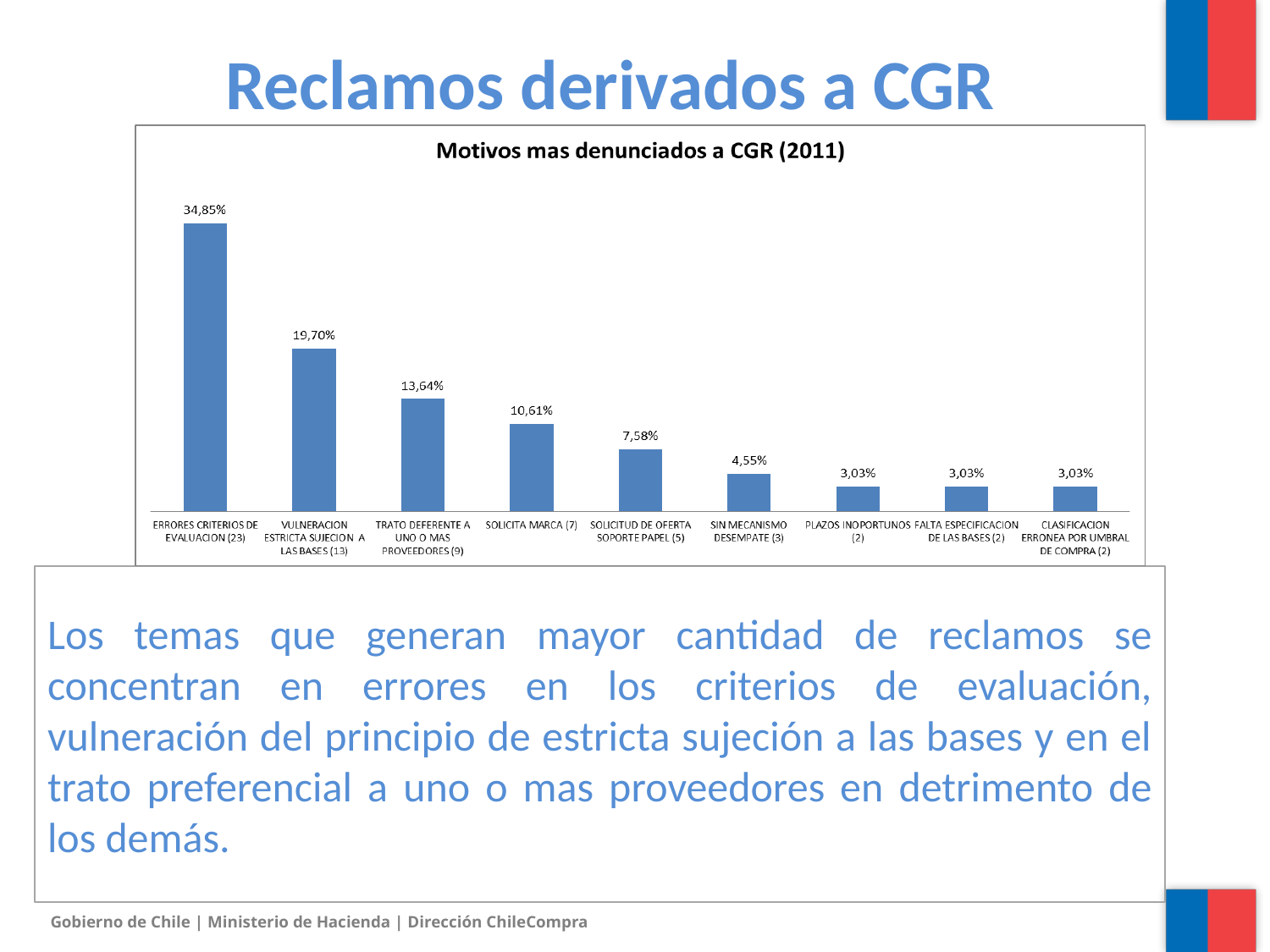
What is the difference between the values for ERRORES CRITERIOS DE EVALUACION (23) and VULNERACION ESTRICTA SUJECION A LAS BASES (13)? 15,15% What is the value for ERRORES CRITERIOS DE EVALUACION (23)? 34,85% What type of chart is shown on the slide? bar chart Which is larger, the value for TRATO DEFERENTE A UNO O MAS PROVEEDORES (9) or SOLICITUD DE OFERTA SOPORTE PAPEL (5)? TRATO DEFERENTE A UNO O MAS PROVEEDORES (9) How many categories are shown in the chart? 9 What is the value for VULNERACION ESTRICTA SUJECION A LAS BASES (13)? 19,70% What is the value for SIN MECANISMO DESEMPATE (3)? 4,55% What is the title of the chart? Motivos mas denunciados a CGR (2011) Which category has the highest value? ERRORES CRITERIOS DE EVALUACION (23) What is the value for SOLICITA MARCA (7)? 10,61% Do the values rise or fall from left to right along the x axis? fall What is the lowest value shown in the chart? 3,03%